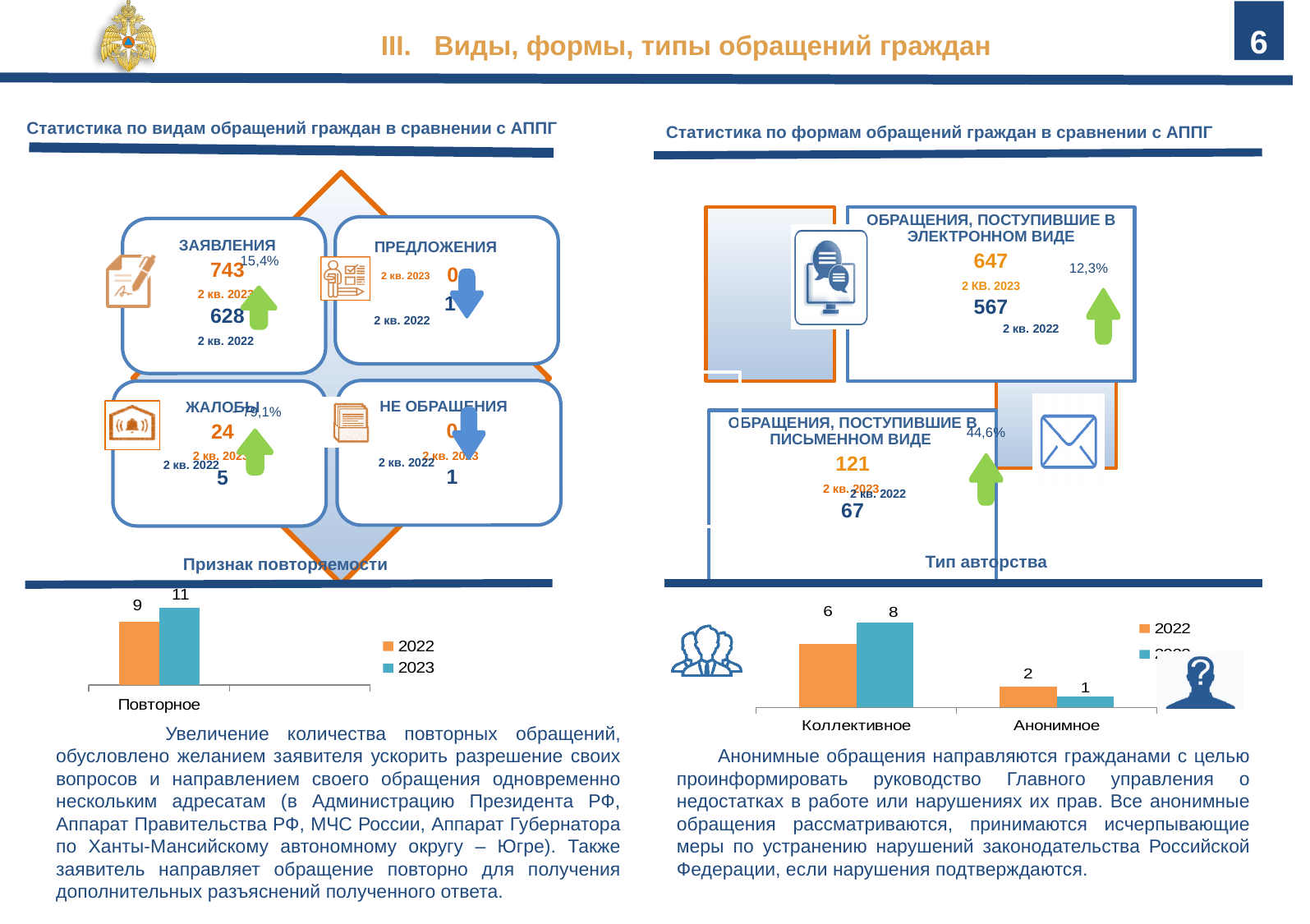
In the 'Тип авторства' chart, how many categories are shown on the x axis? 2 In the 'Признак повторяемости' chart, what is the value for 2023 for Повторное? 11 In the 'Тип авторства' chart, what is the difference between the 2023 and 2022 values for Коллективное? 2 What kind of chart is the 'Признак повторяемости' chart? Bar chart In the 'Тип авторства' chart, what is the 2023 value for Анонимное? 1 In the 'Признак повторяемости' chart, what is the difference between the 2023 and 2022 values for Повторное? 2 In the 'Тип авторства' chart, what is the 2022 value for Анонимное? 2 How many series does the legend of the 'Признак повторяемости' chart list? 2 In the 'Признак повторяемости' chart, which series has the larger value for Повторное, 2022 or 2023? 2023 In the 'Тип авторства' chart, what is the 2023 value for Коллективное? 8 In the 'Признак повторяемости' chart, what is the value for 2022 for Повторное? 9 In the 'Тип авторства' chart, what is the 2022 value for Коллективное? 6